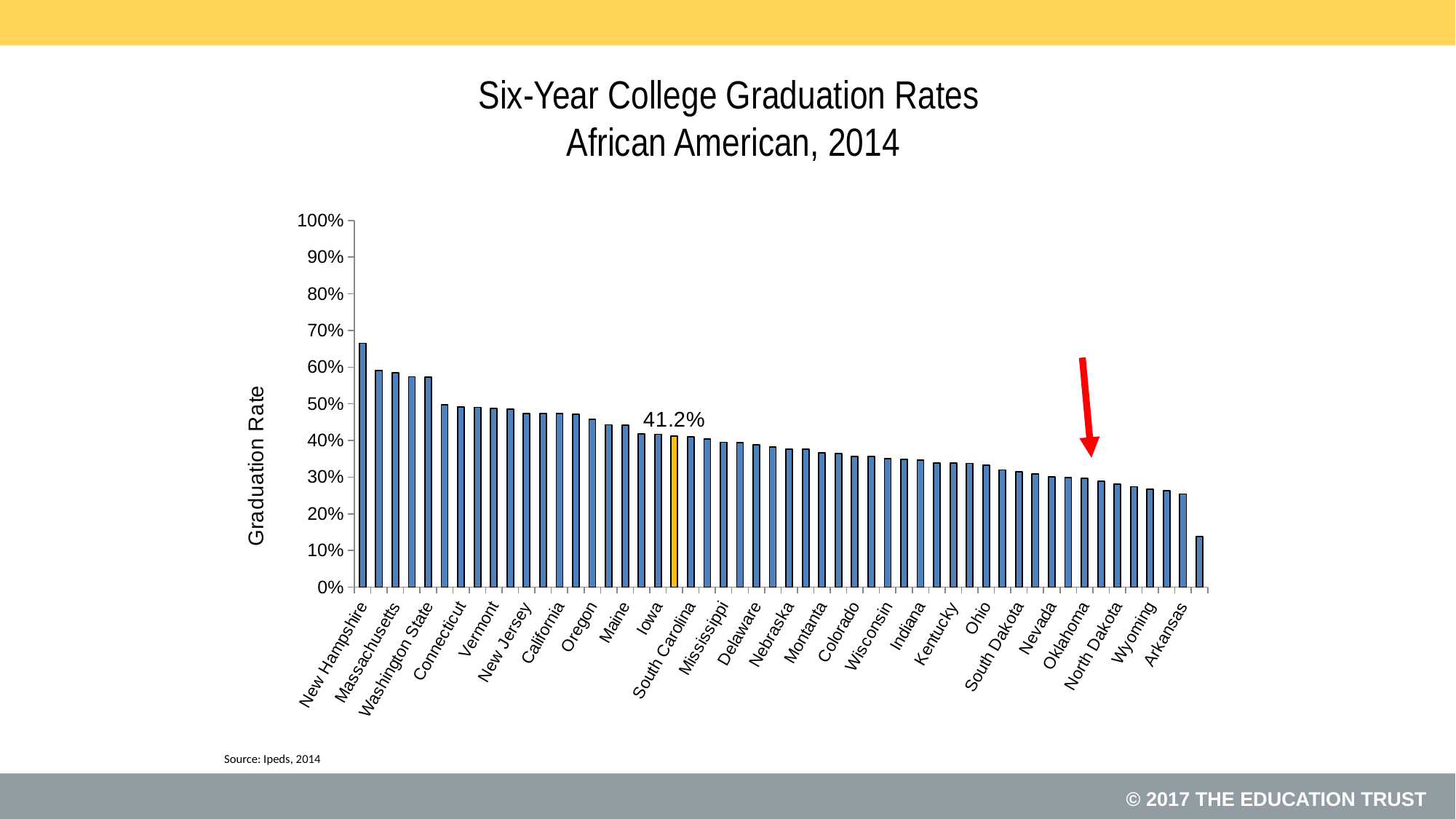
Do the graduation rates rise or fall moving from left to right along the x axis? fall Which has the higher graduation rate, Vermont or Ohio? Vermont Which labeled state has the highest graduation rate? New Hampshire What kind of chart is shown on the slide? bar chart Is the value for Wyoming greater or less than 30%? less What value is printed as a data label on the highlighted yellow bar? 41.2% Which has the lower graduation rate, New Hampshire or Arkansas? Arkansas Is the value for New Hampshire greater or less than 60%? greater What is the label on the vertical axis? Graduation Rate Is the value for Arkansas greater or less than 20%? greater What is the title of the chart? Six-Year College Graduation Rates African American, 2014